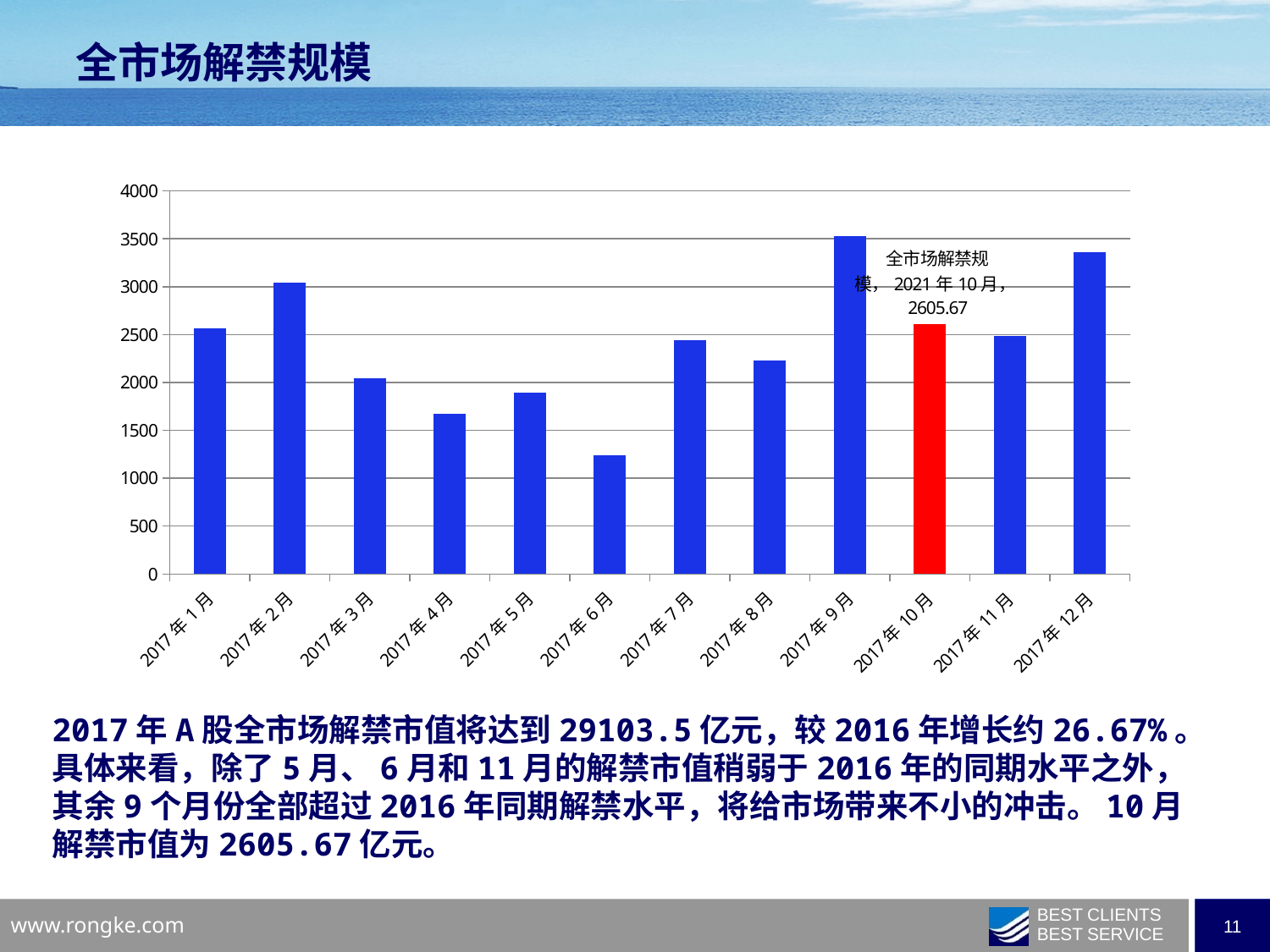
Is the value for 2017年6月 greater or less than 1500? less Is the value for 2017年12月 greater or less than 3500? less Is the value for 2017年8月 greater or less than 2000? greater What kind of chart is shown on the slide? bar chart Which is larger, the value for 2017年7月 or 2017年8月? 2017年7月 Which month's bar is coloured red? 2017年10月 Which month has the lowest bar? 2017年6月 Which is larger, the value for 2017年2月 or 2017年12月? 2017年12月 What is the value for 2017年10月? 2605.67 Which month has the highest bar? 2017年9月 How many months are shown on the x axis? 12